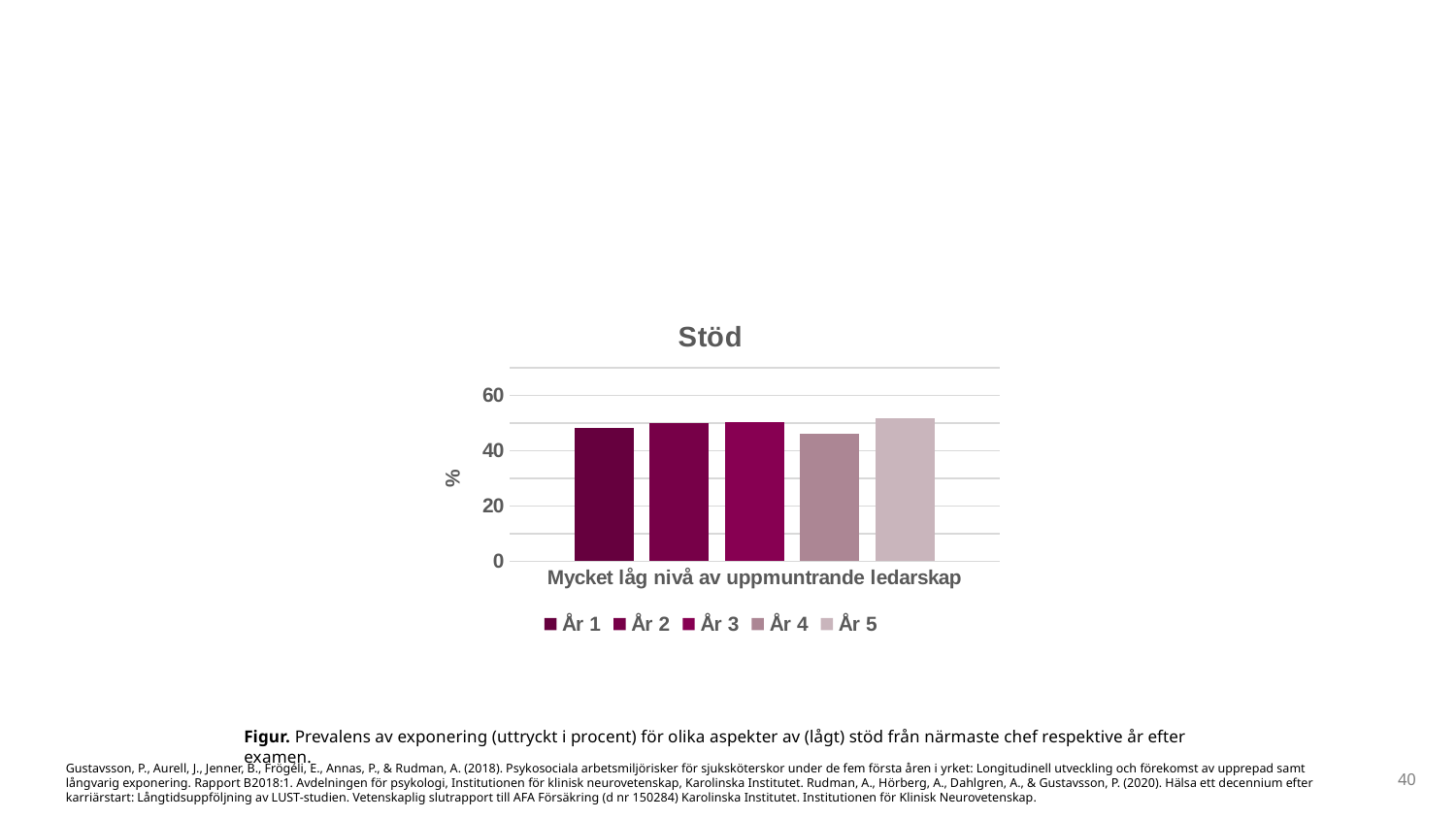
Is the value for År 5 greater or less than 60? less What is the label on the vertical axis? % Which is larger, the value for År 3 or the value for År 4? År 3 Is the value for År 1 greater or less than 40? greater What kind of chart is shown on the slide? bar chart Which is larger, the value for År 5 or the value for År 4? År 5 What is the name of the category shown on the x axis? Mycket låg nivå av uppmuntrande ledarskap Is the value for År 4 greater or less than 40? greater How many series does the legend list? 5 What is the title of the chart? Stöd How many categories are shown on the x axis? 1